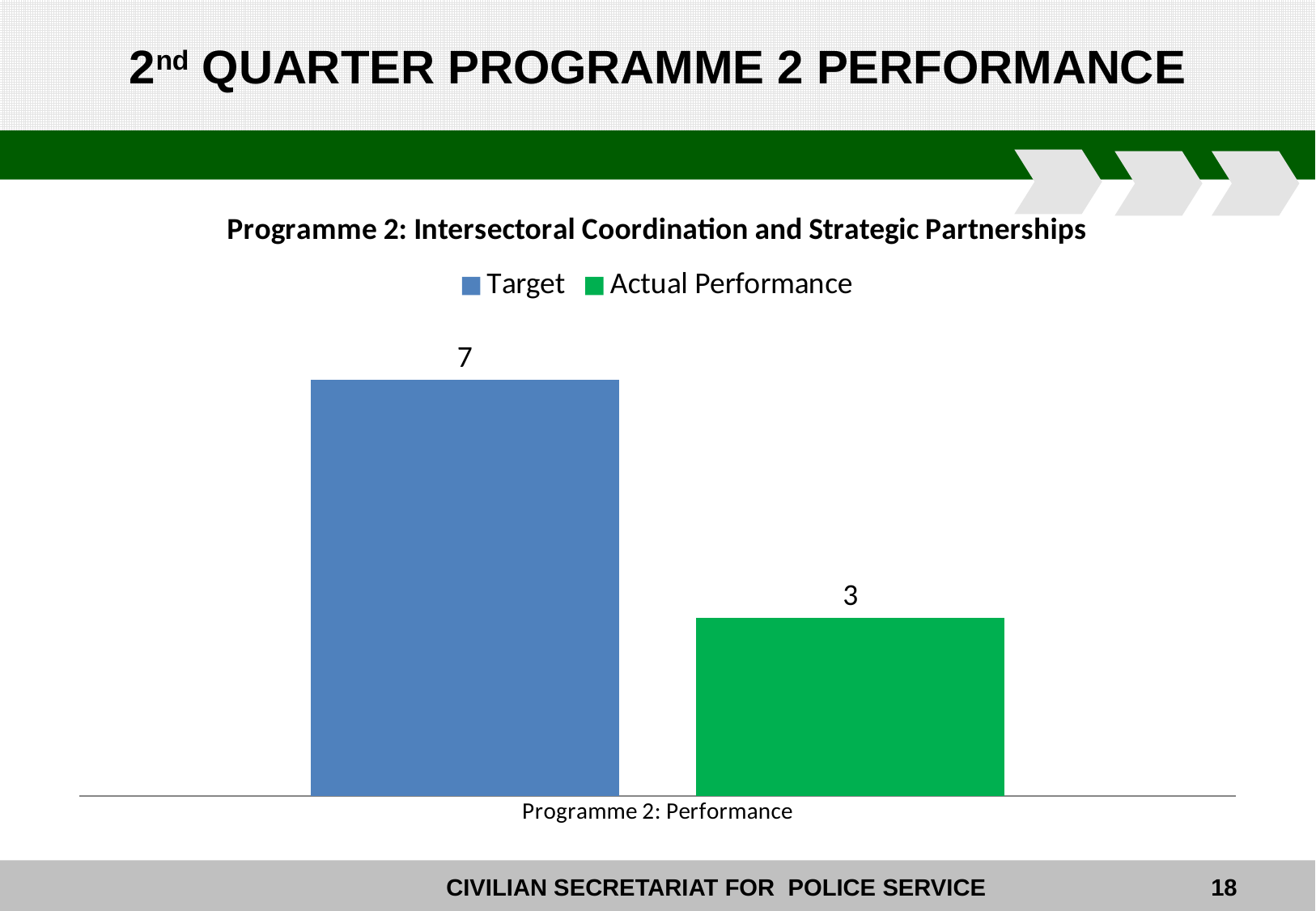
What kind of chart is shown on the slide? Bar chart How many bars are plotted in the chart? 2 What colour is the Actual Performance bar? Green What is the Target value shown in the chart? 7 Which series has the lowest value in the chart? Actual Performance What is the title of the chart? Programme 2: Intersectoral Coordination and Strategic Partnerships What is the difference between the Target and the Actual Performance values? 4 Which series has the higher value, Target or Actual Performance? Target How many series does the legend list? 2 What is the Actual Performance value shown in the chart? 3 What is the category label shown on the x axis? Programme 2: Performance